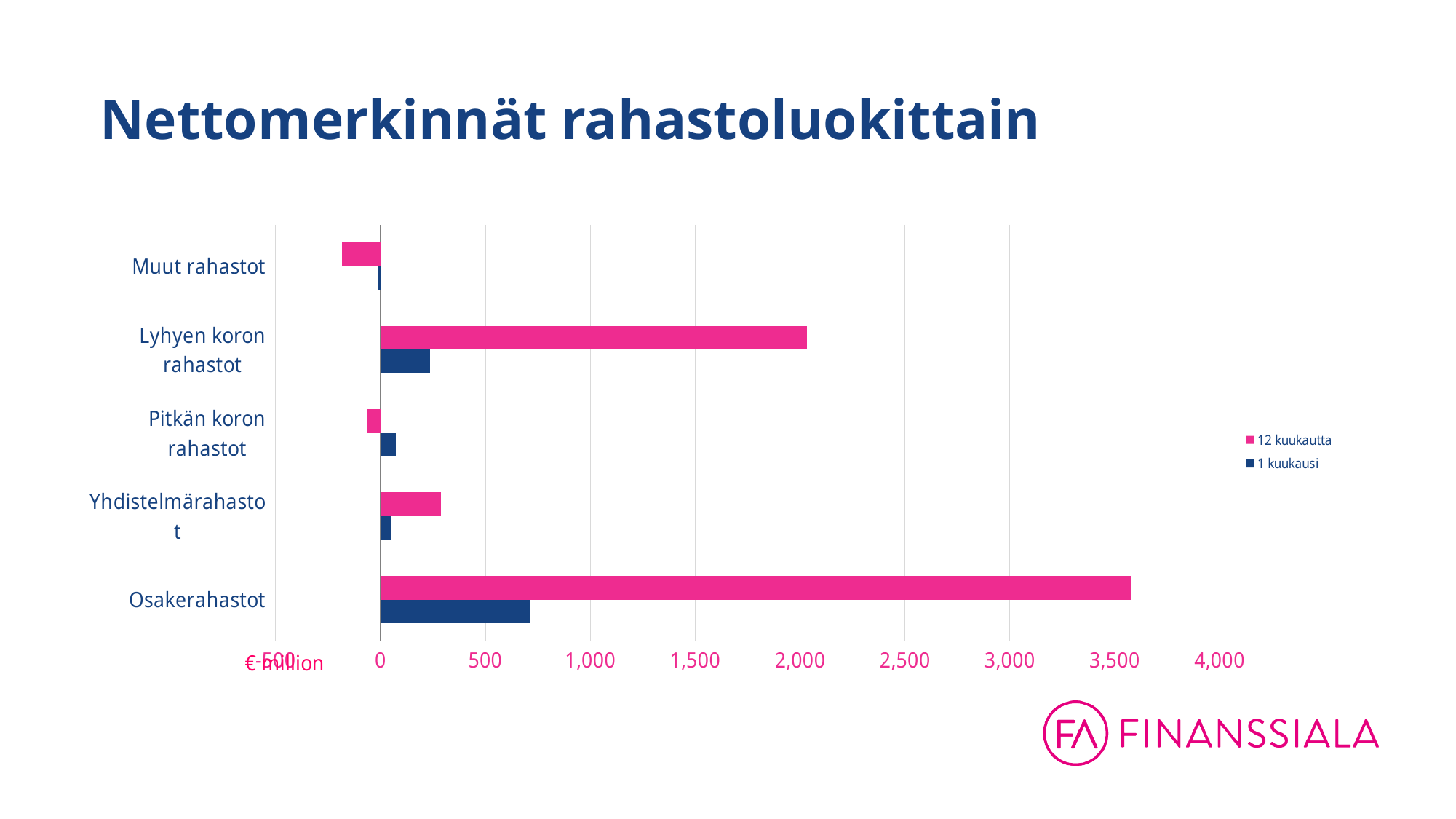
Which is larger for Lyhyen koron rahastot: the 12 kuukautta value or the 1 kuukausi value? 12 kuukautta What is the title of the chart on the slide? Nettomerkinnät rahastoluokittain Is the 12 kuukautta value for Lyhyen koron rahastot greater or less than 2,000? greater Is the 1 kuukausi value for Osakerahastot greater or less than 500? greater Which category has the highest value for the 1 kuukausi series? Osakerahastot Is the 12 kuukautta value for Osakerahastot greater or less than 3,500? greater How many fund categories are shown on the chart? 5 Which category has the highest value for the 12 kuukautta series? Osakerahastot What kind of chart is shown on the slide? bar chart Which colour represents the 1 kuukausi series in the chart? dark blue How many series does the legend list? 2 Which category has the lowest value for the 12 kuukautta series? Muut rahastot